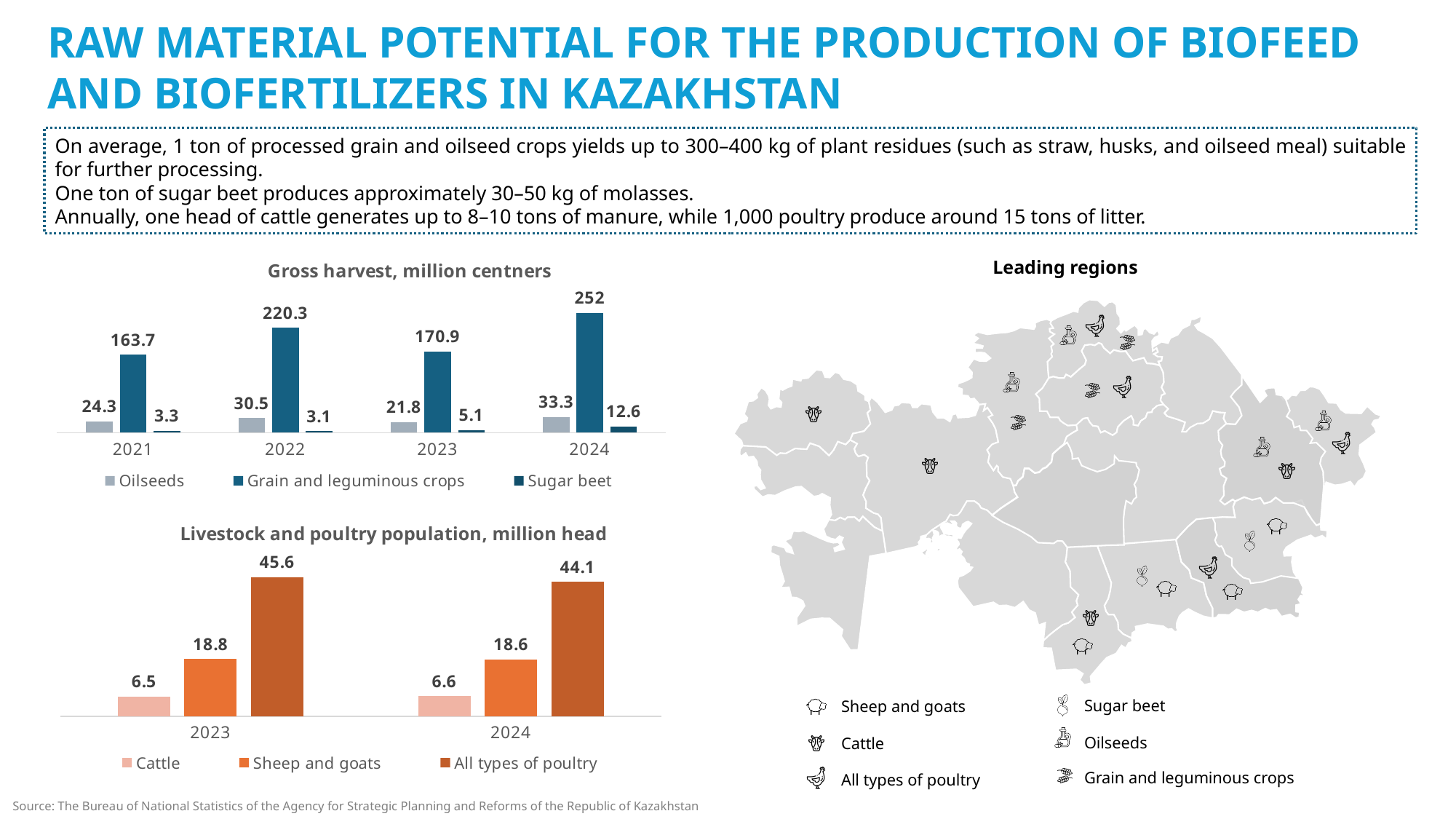
In the 'Livestock and poultry population, million head' chart, what is the difference between the Sheep and goats values for 2023 and 2024? 0.2 In the 'Gross harvest, million centners' chart, how many series does the legend list? 3 In the 'Gross harvest, million centners' chart, what is the value for Grain and leguminous crops in 2024? 252 In the 'Gross harvest, million centners' chart, which year has the lowest value for Oilseeds? 2023 In the 'Livestock and poultry population, million head' chart, which is larger: All types of poultry in 2023 or in 2024? 2023 What kind of chart is the 'Livestock and poultry population, million head' chart? Bar chart In the 'Livestock and poultry population, million head' chart, what is the value for All types of poultry in 2023? 45.6 In the 'Gross harvest, million centners' chart, what is the value for Sugar beet in 2023? 5.1 In the 'Gross harvest, million centners' chart, what is the value for Oilseeds in 2022? 30.5 In the 'Gross harvest, million centners' chart, what is the difference between the Grain and leguminous crops values for 2022 and 2021? 56.6 In the 'Livestock and poultry population, million head' chart, what is the value for Cattle in 2024? 6.6 In the 'Gross harvest, million centners' chart, which year has the highest value for Grain and leguminous crops? 2024